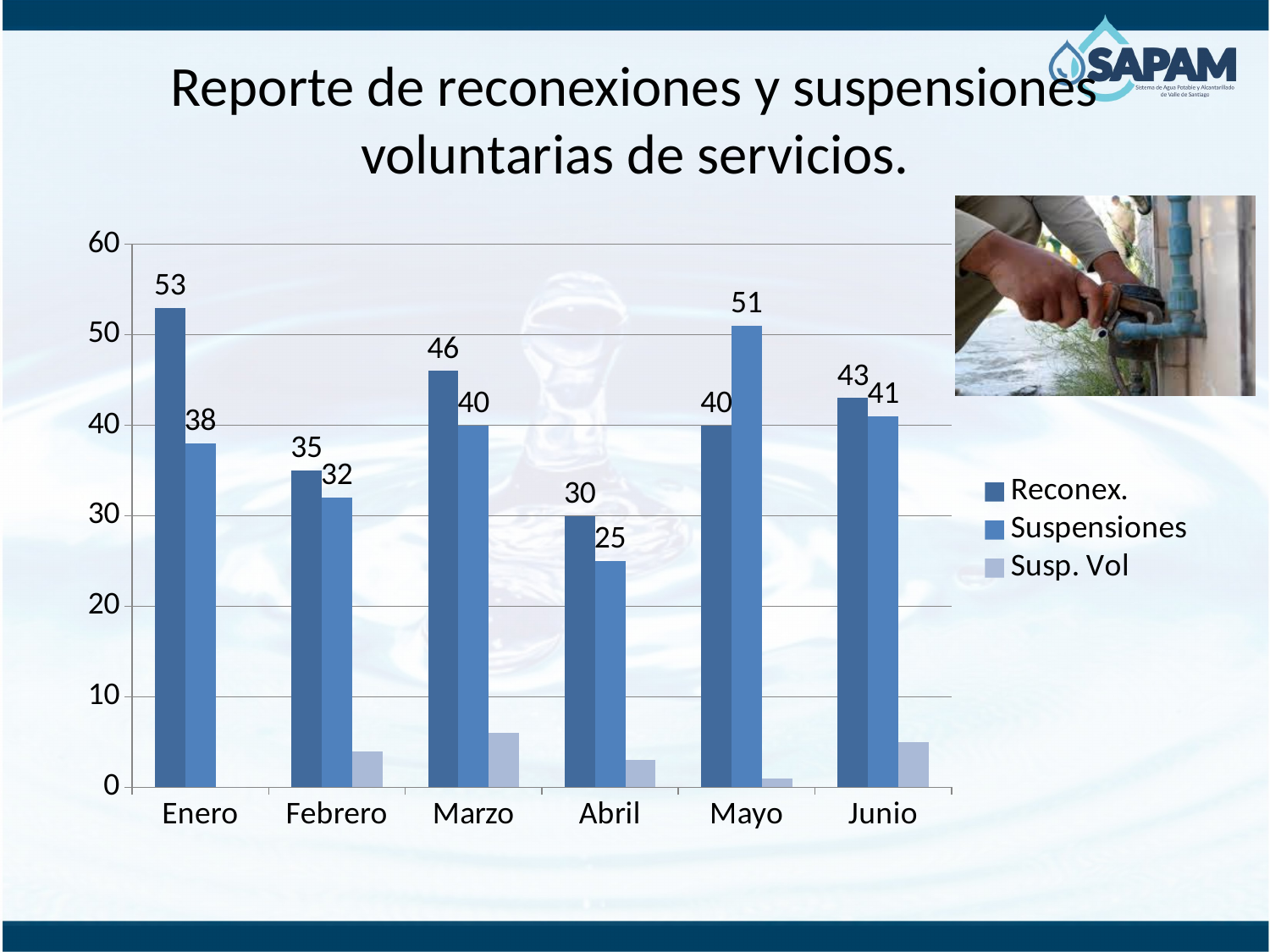
How many series does the legend list? 3 In Mayo, which is larger: Reconex. or Suspensiones? Suspensiones What is the difference between Reconex. and Suspensiones in Enero? 15 What is the value of Suspensiones for Mayo? 51 What is the value of Reconex. for Enero? 53 What kind of chart is shown on the slide? bar chart What are the three series named in the legend? Reconex., Suspensiones, Susp. Vol Is the value of Susp. Vol for Marzo greater or less than 10? less In which month is the Reconex. value highest? Enero How many months are shown on the x axis? 6 What is the value of Reconex. for Abril? 30 In which month is the Suspensiones value lowest? Abril